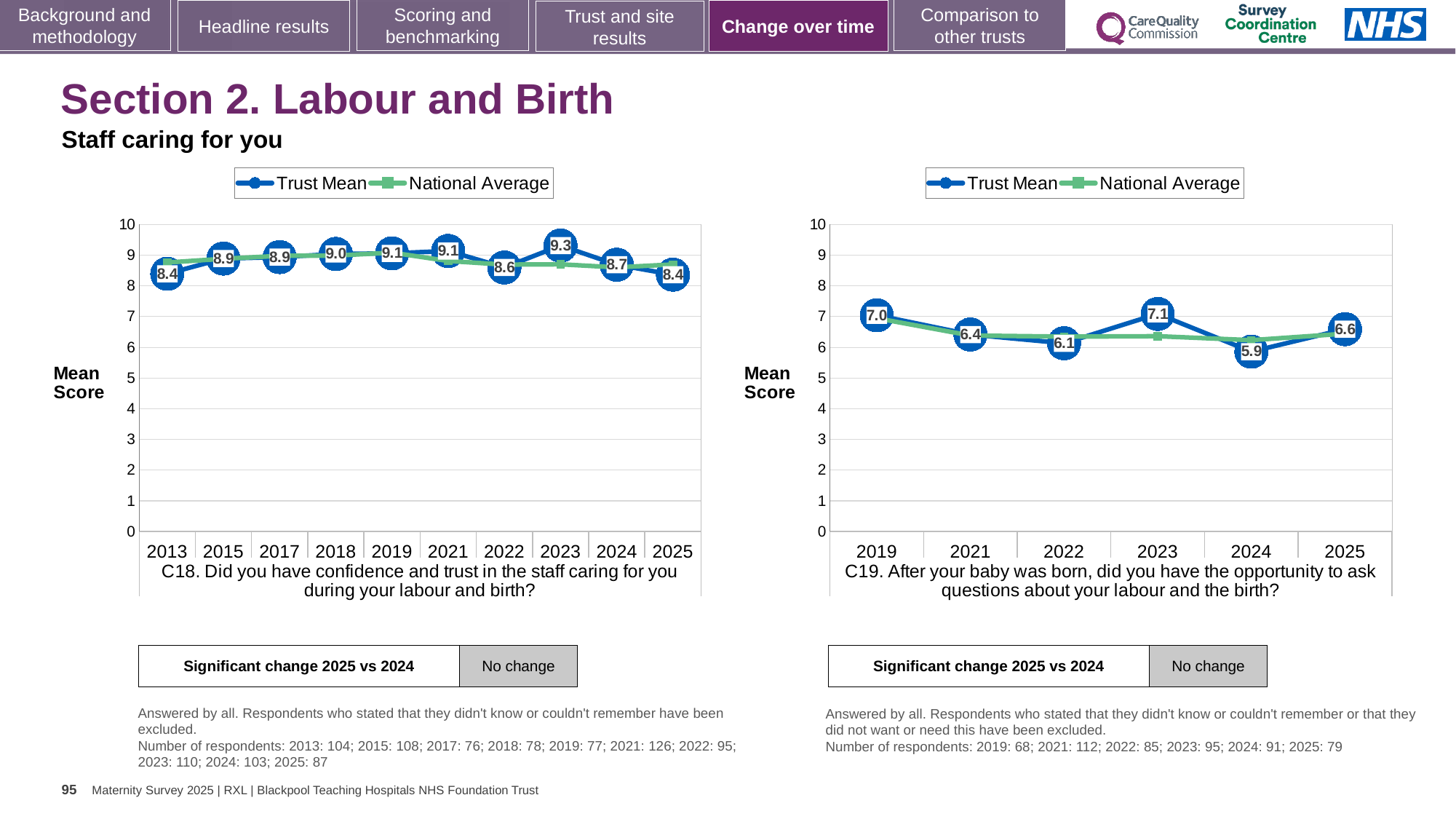
In the C19 chart (right), is the Trust Mean higher in 2019 or in 2021? 2019 What type of chart is used for the C19 question on the right? Line chart In the C19 chart (right), which year has the highest Trust Mean? 2023 How many series does the legend of the C18 chart (left) list? 2 In the C18 chart (left), what is the Trust Mean for 2023? 9.3 In the C18 chart (left), how many years are plotted on the x axis? 10 In the C18 chart (left), what is the Trust Mean for 2013? 8.4 In the C18 chart (left), which year has the highest Trust Mean? 2023 In the C19 chart (right), what is the difference between the Trust Mean in 2025 and in 2024? 0.7 In the C18 chart (left), what is the difference between the Trust Mean in 2023 and in 2025? 0.9 In the C19 chart (right), what is the Trust Mean for 2024? 5.9 In the C19 chart (right), which year has the lowest Trust Mean? 2024